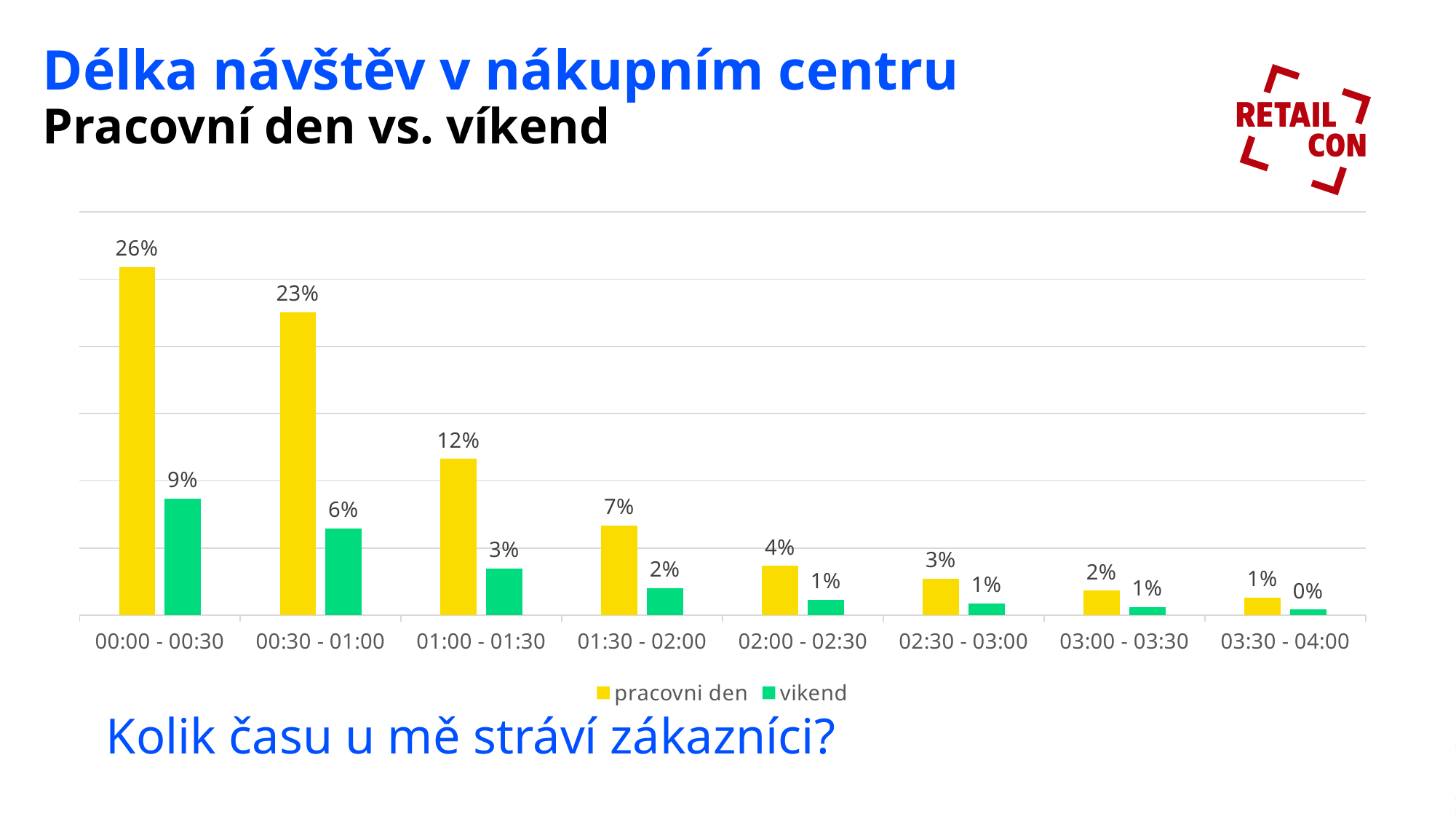
How many time categories are shown on the x axis? 8 How many series does the legend list? 2 What is the value for 'vikend' in the 03:30 - 04:00 category? 0% What is the value for 'pracovni den' in the 00:00 - 00:30 category? 26% What is the value for 'vikend' in the 00:30 - 01:00 category? 6% What is the difference between the 'pracovni den' and 'vikend' values in the 01:00 - 01:30 category? 9% What kind of chart is shown on the slide? bar chart Which is larger in the 01:30 - 02:00 category: 'pracovni den' or 'vikend'? pracovni den Which colour represents the 'vikend' series? green Do the 'pracovni den' values rise or fall from left to right along the x axis? fall Which category has the highest 'pracovni den' value? 00:00 - 00:30 Which category has the lowest 'vikend' value? 03:30 - 04:00